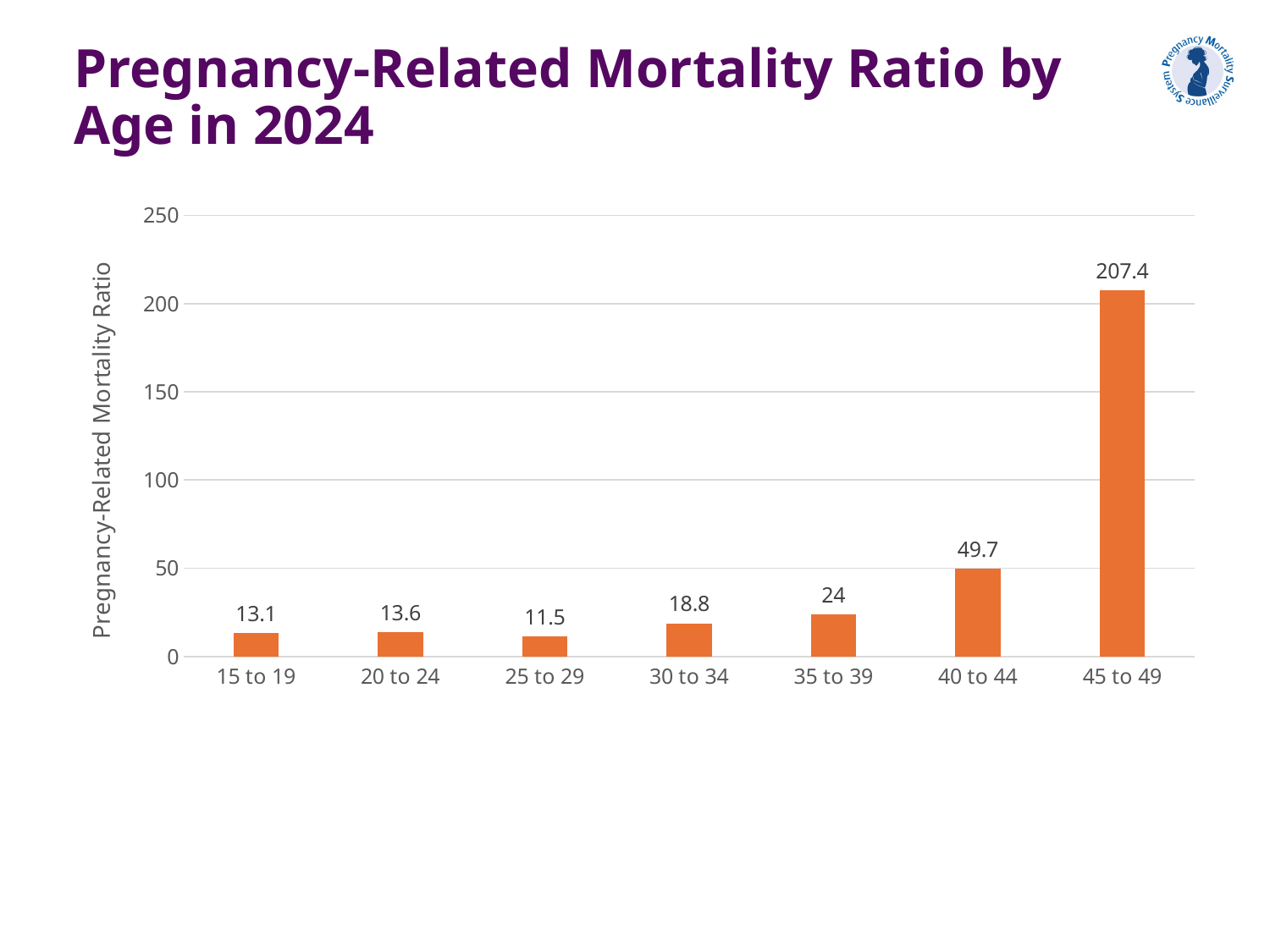
Which age group has the highest pregnancy-related mortality ratio? 45 to 49 Which age group has a higher pregnancy-related mortality ratio, 20 to 24 or 25 to 29? 20 to 24 Is the value for the 45 to 49 age group greater or less than 200? greater How many age groups are shown on the chart? 7 What kind of chart is shown on the slide? Bar chart What is the pregnancy-related mortality ratio for the 30 to 34 age group? 18.8 What is the pregnancy-related mortality ratio for the 45 to 49 age group? 207.4 What is the difference between the pregnancy-related mortality ratio for 45 to 49 and for 40 to 44? 157.7 What is the pregnancy-related mortality ratio for the 40 to 44 age group? 49.7 What is the label on the vertical axis of the chart? Pregnancy-Related Mortality Ratio Which age group has the lowest pregnancy-related mortality ratio? 25 to 29 What is the difference between the pregnancy-related mortality ratio for 35 to 39 and for 30 to 34? 5.2